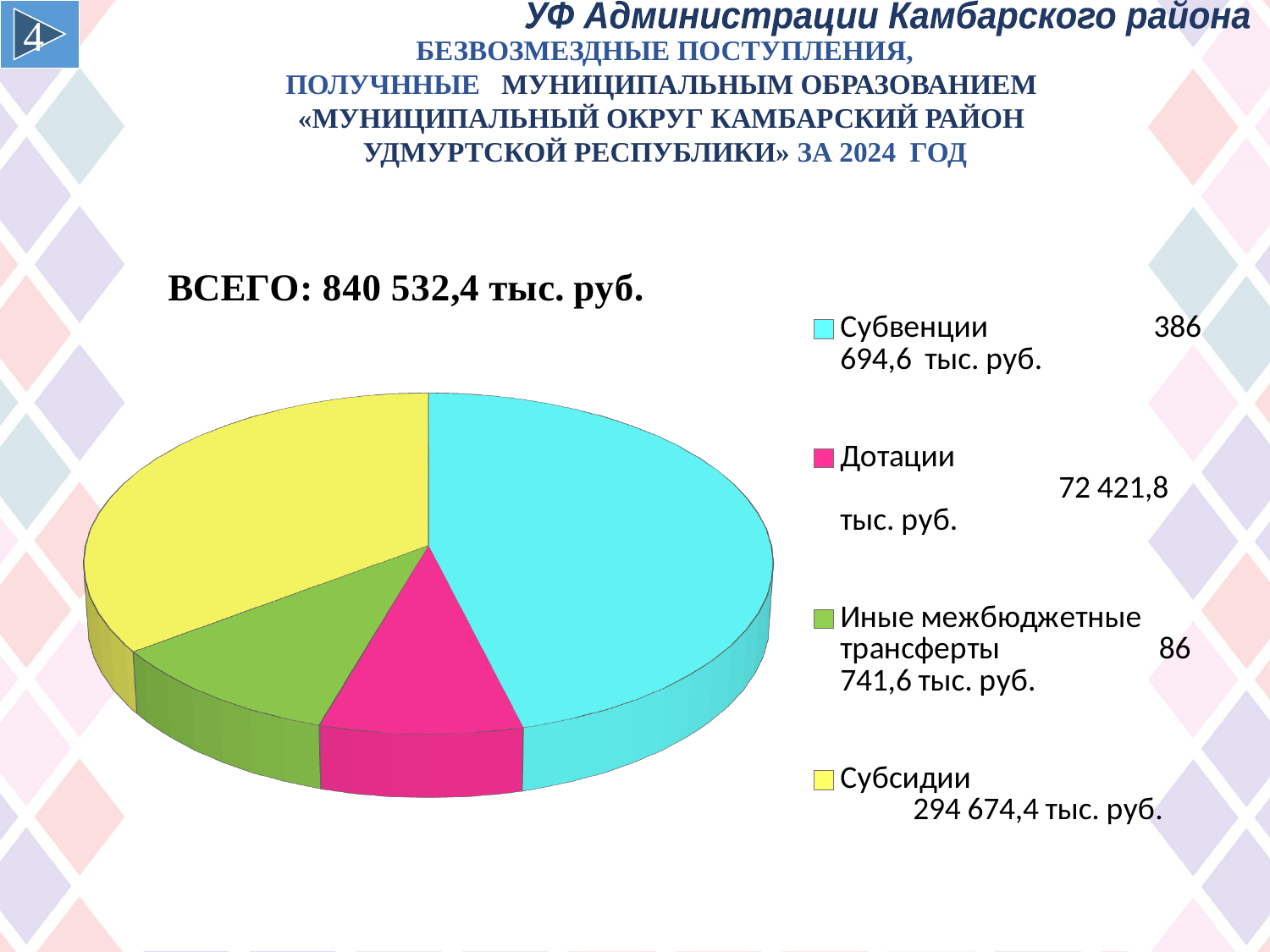
What is the difference between Субвенции and Субсидии? 92 020,2 тыс. руб. Which category has the smallest value? Дотации What is the value for Иные межбюджетные трансферты? 86 741,6 тыс. руб. What is the value for Субвенции? 386 694,6 тыс. руб. Which category has the largest value? Субвенции Which is larger, Иные межбюджетные трансферты or Дотации? Иные межбюджетные трансферты What is the total of all categories shown on the slide? 840 532,4 тыс. руб. What colour is the Субсидии slice in the pie chart? Yellow What kind of chart is shown on the slide? Pie chart How many categories does the pie chart show? 4 What is the value for Субсидии? 294 674,4 тыс. руб. What is the value for Дотации? 72 421,8 тыс. руб.